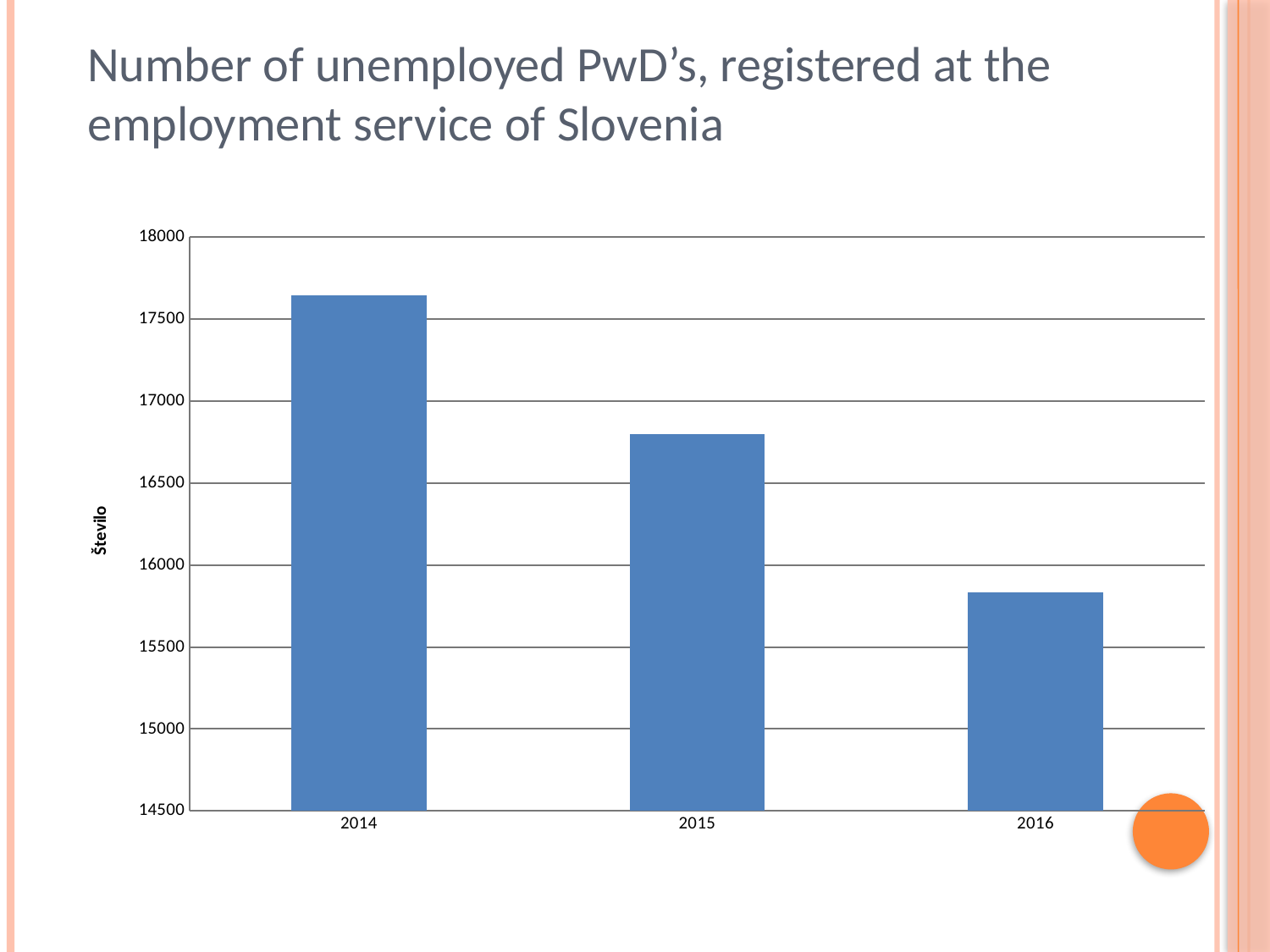
Is the value for 2016 greater or less than 16000? less Is the value for 2014 greater or less than 17500? greater What is the label on the vertical axis of the chart? Število Is the value for 2016 greater or less than 15500? greater How many bars (years) are shown in the chart? 3 Which year has the highest number of unemployed PwD's? 2014 Which is larger, the value for 2014 or the value for 2015? 2014 Do the values rise or fall from 2014 to 2016? fall What is the title of the slide containing the chart? Number of unemployed PwD's, registered at the employment service of Slovenia What kind of chart is shown on the slide? bar chart Which year has the lowest number of unemployed PwD's? 2016